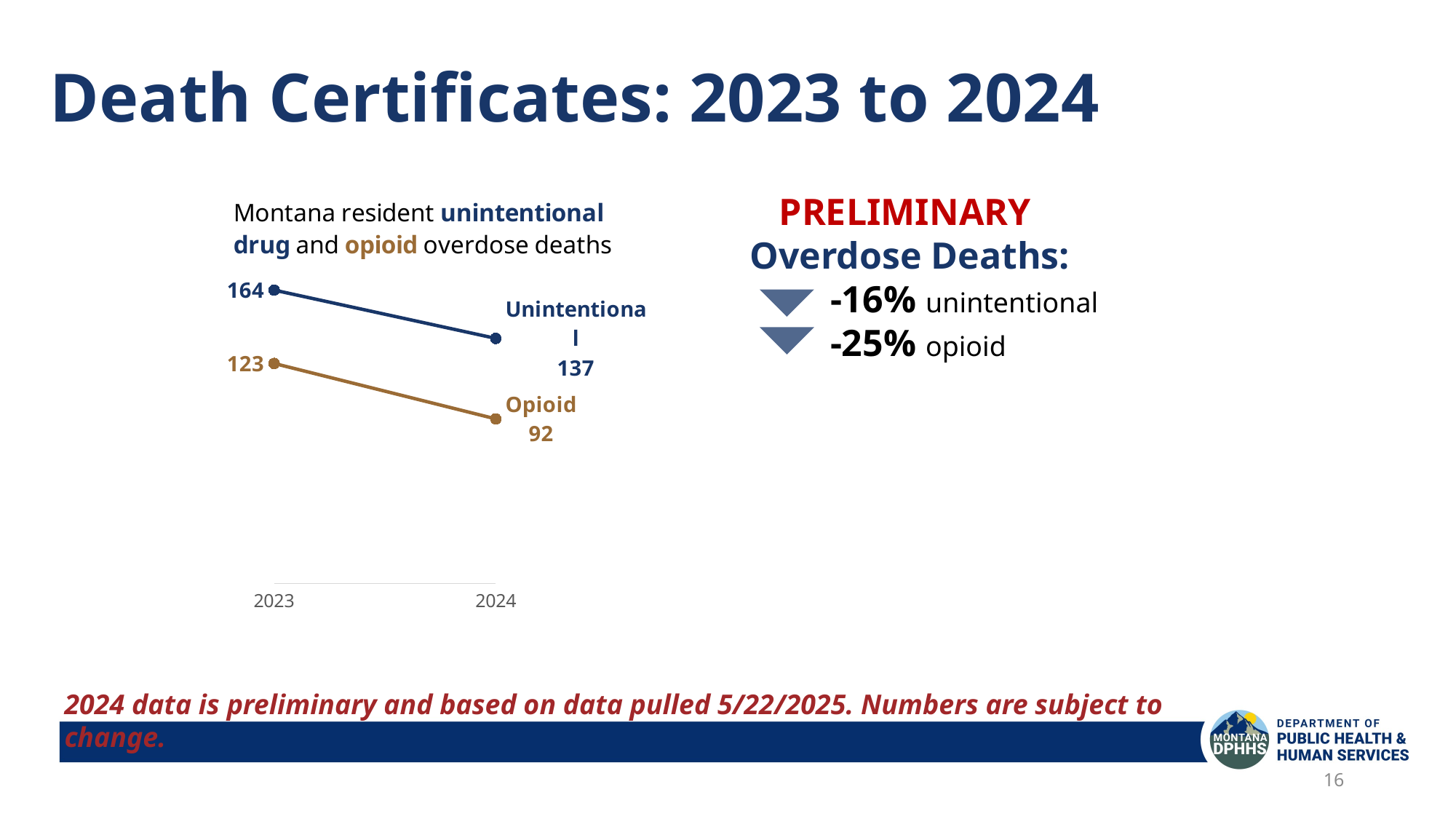
What was the number of opioid overdose deaths in 2024? 92 What is the difference between unintentional and opioid overdose deaths in 2024? 45 What kind of chart is shown on the slide? Line chart What was the number of unintentional drug overdose deaths in 2024? 137 By how much did unintentional drug overdose deaths fall from 2023 to 2024? 27 Do the unintentional overdose deaths rise or fall from 2023 to 2024? Fall How many series are plotted in the chart? 2 By how much did opioid overdose deaths fall from 2023 to 2024? 31 What was the number of opioid overdose deaths in 2023? 123 What was the number of unintentional drug overdose deaths in 2023? 164 Which series had more deaths in 2023, Unintentional or Opioid? Unintentional How many years are plotted on the x axis of the chart? 2